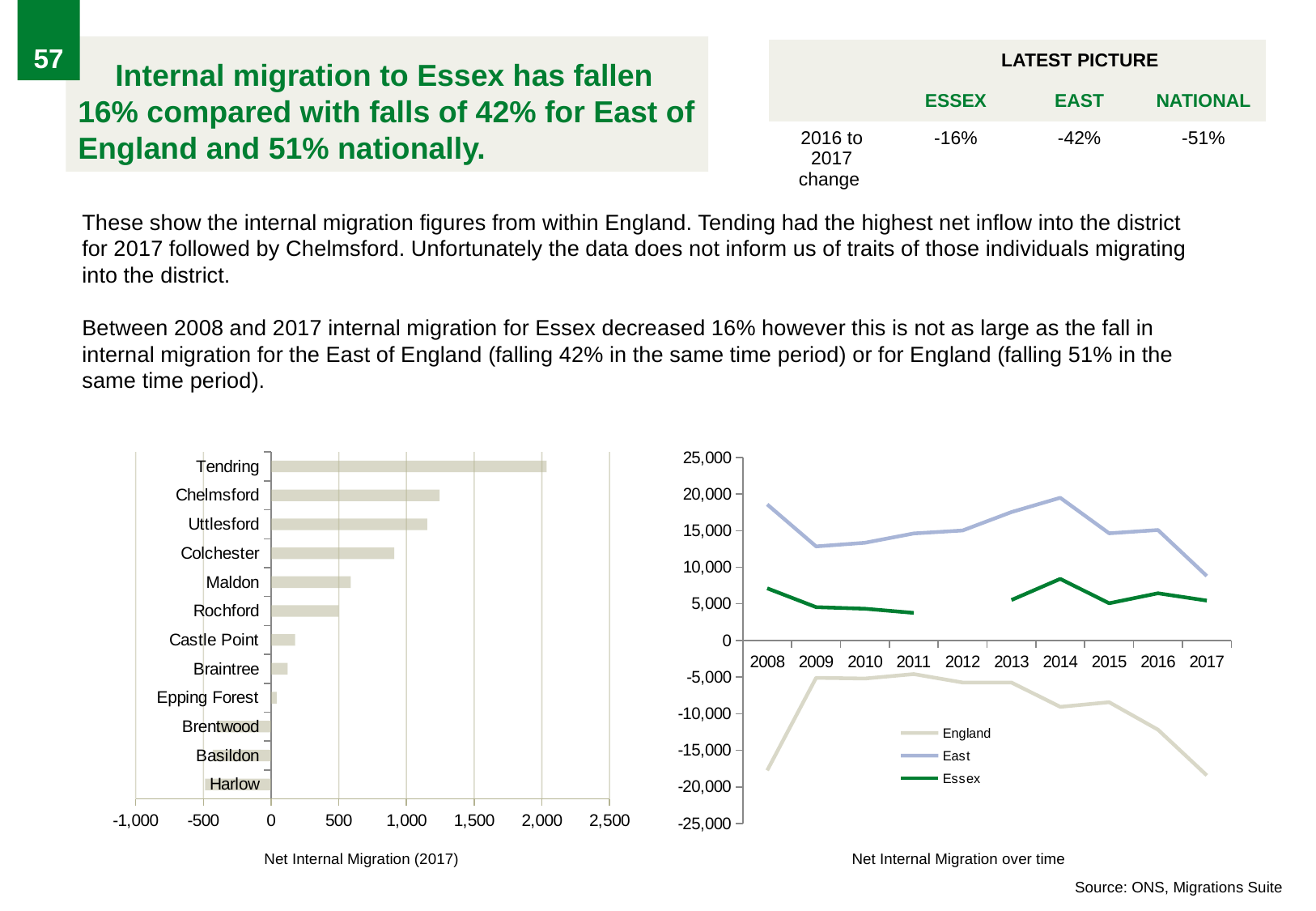
In the 'Net Internal Migration over time' chart, is the value for East in 2008 greater or less than 15,000? greater In the 'Net Internal Migration (2017)' chart, which is larger, the value for Chelmsford or the value for Maldon? Chelmsford In the 'Net Internal Migration (2017)' chart, is the value for Colchester greater or less than 1,000? less What kind of chart is the 'Net Internal Migration (2017)' chart on the left? bar chart In the 'Net Internal Migration over time' chart, which series has the lowest values across the years shown? England In the 'Net Internal Migration (2017)' chart, which district has the lowest net internal migration? Harlow How many districts are shown in the 'Net Internal Migration (2017)' chart? 12 In the 'Net Internal Migration (2017)' chart, which district has the highest net internal migration? Tendring How many series does the legend of the 'Net Internal Migration over time' chart list? 3 What kind of chart is the 'Net Internal Migration over time' chart on the right? line chart In the 'Net Internal Migration over time' chart, does the East series rise or fall between 2016 and 2017? fall In the 'Net Internal Migration (2017)' chart, is the value for Tendring greater or less than 1,500? greater